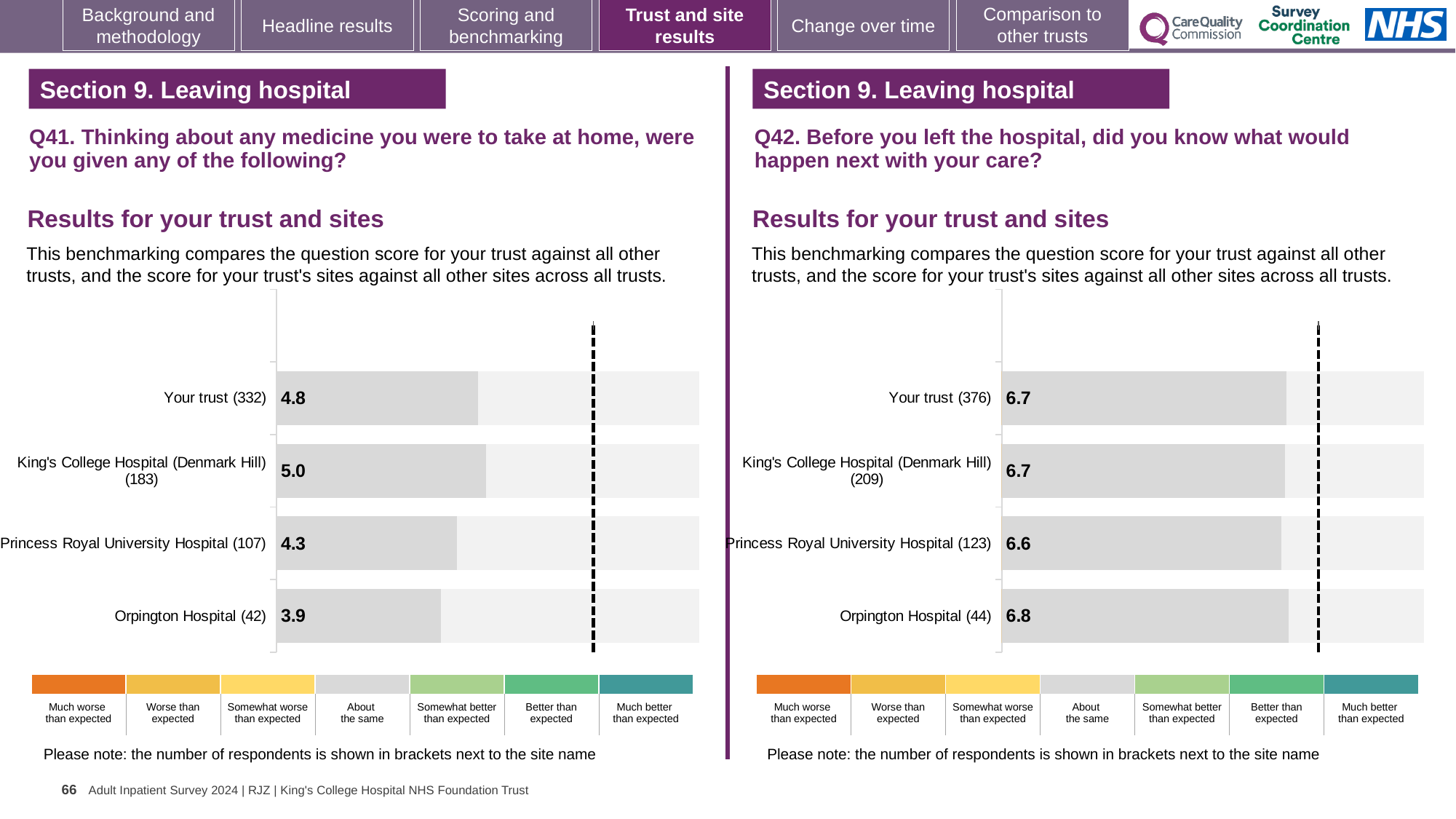
In the Q41 chart on the left, what is the score for Orpington Hospital? 3.9 In the Q41 chart on the left, what is the score for Your trust? 4.8 In the Q42 chart on the right, which site or trust has the highest score? Orpington Hospital In the Q42 chart on the right, what is the score for King's College Hospital (Denmark Hill)? 6.7 In the Q41 chart on the left, which site or trust has the highest score? King's College Hospital (Denmark Hill) In the Q42 chart on the right, what is the score for Princess Royal University Hospital? 6.6 What type of chart is used in the Q42 chart on the right? Bar chart In the Q42 chart on the right, what is the difference between the scores for Orpington Hospital and Princess Royal University Hospital? 0.2 In the Q41 chart on the left, how many respondents are shown in brackets for Orpington Hospital? 42 In the Q41 chart on the left, which site or trust has the lowest score? Orpington Hospital In the Q41 chart on the left, what is the difference between the scores for King's College Hospital (Denmark Hill) and Princess Royal University Hospital? 0.7 In the Q41 chart on the left, how many bars are plotted? 4